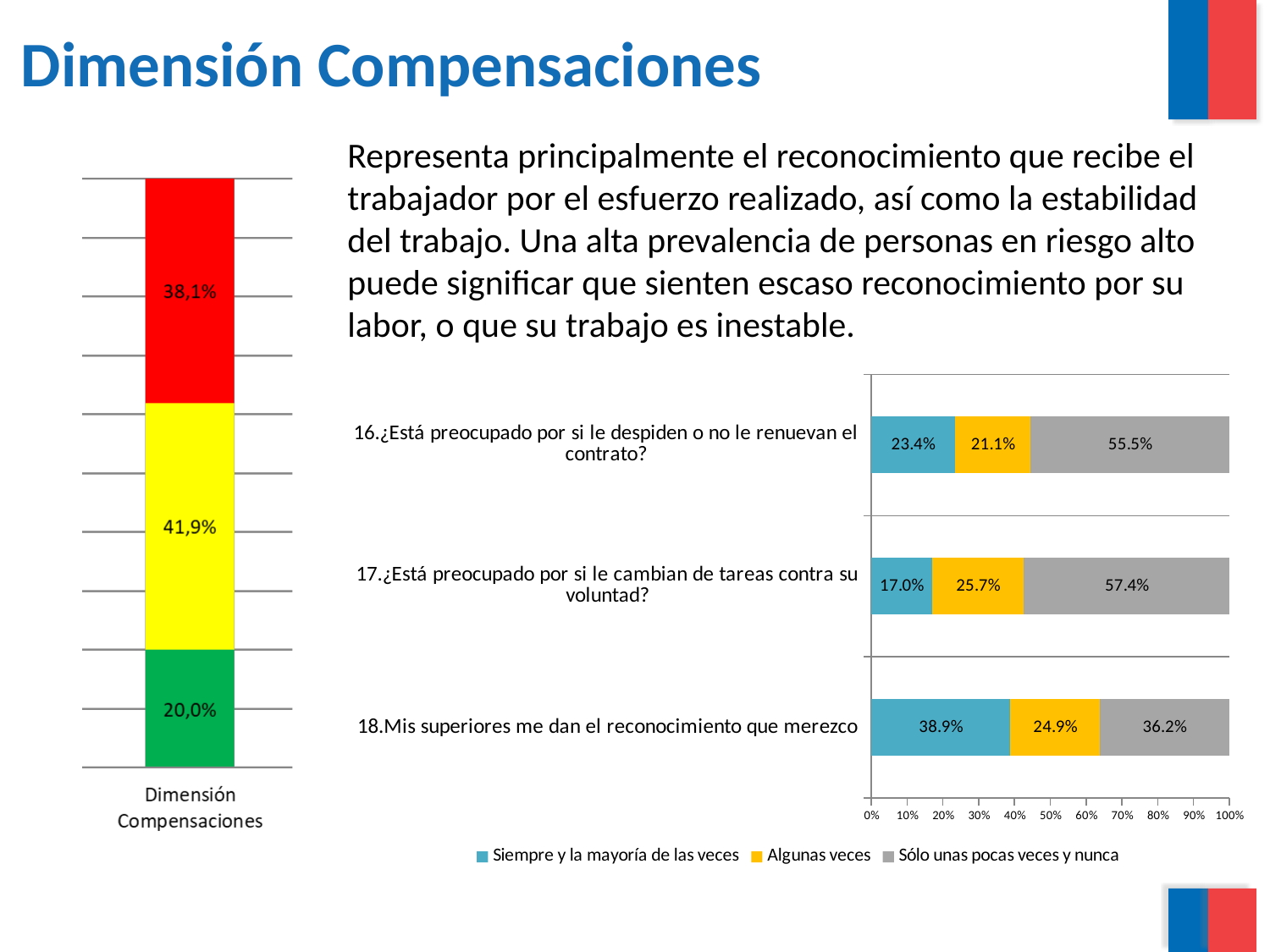
In the horizontal stacked bar chart on the right, which is larger: the 'Siempre y la mayoría de las veces' value for question 16 or for question 17? Question 16 (23.4%) In the stacked bar chart on the left titled 'Dimensión Compensaciones', which segment has the smallest value? The green segment (20,0%) In the stacked bar chart on the left titled 'Dimensión Compensaciones', what is the value of the red segment? 38,1% In the horizontal stacked bar chart on the right, which question has the lowest value for 'Siempre y la mayoría de las veces'? 17.¿Está preocupado por si le cambian de tareas contra su voluntad? In the horizontal stacked bar chart on the right, what is the value of 'Siempre y la mayoría de las veces' for question 18 (Mis superiores me dan el reconocimiento que merezco)? 38.9% In the horizontal stacked bar chart on the right, what is the difference between the 'Sólo unas pocas veces y nunca' values for question 17 and question 18? 21.2% In the horizontal stacked bar chart on the right, what is the value of 'Algunas veces' for question 17 (¿Está preocupado por si le cambian de tareas contra su voluntad?)? 25.7% What kind of chart is the chart on the right of the slide? Stacked bar chart In the horizontal stacked bar chart on the right, which question has the highest value for 'Sólo unas pocas veces y nunca'? 17.¿Está preocupado por si le cambian de tareas contra su voluntad? How many series does the legend of the horizontal stacked bar chart on the right list? 3 In the horizontal stacked bar chart on the right, what is the value of 'Sólo unas pocas veces y nunca' for question 16 (¿Está preocupado por si le despiden o no le renuevan el contrato?)? 55.5% How many questions (categories) are shown in the horizontal stacked bar chart on the right? 3